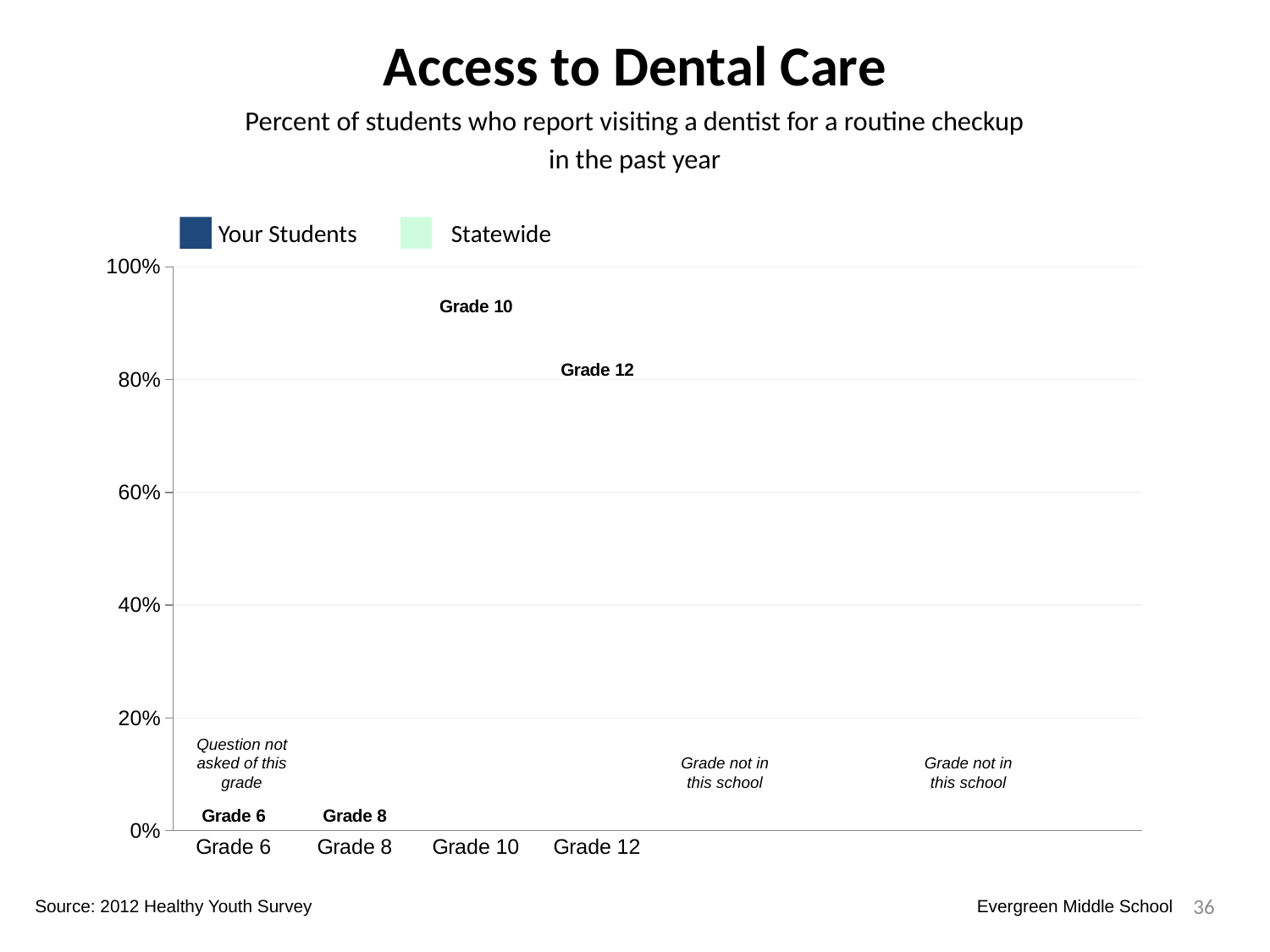
How many grade categories are shown on the x axis? 4 What are the two series named in the legend? Your Students and Statewide How many series does the legend list? 2 What is the maximum value shown on the y axis? 100% What is the title of the chart? Access to Dental Care